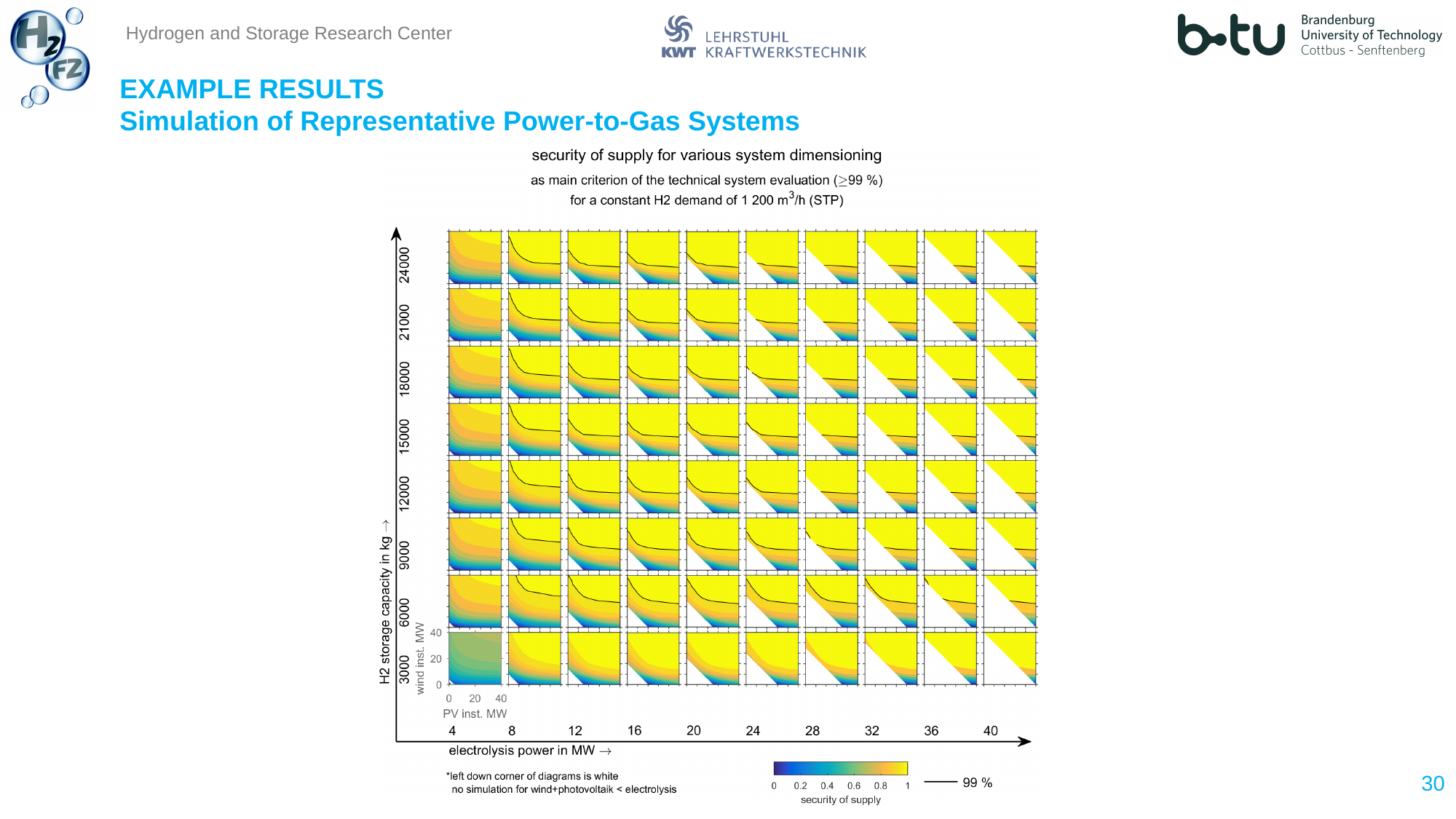
How many H2 storage capacity values are shown along the y axis of the grid? 8 What is the maximum wind installed capacity shown on the axis of each small diagram? 40 MW What is the largest electrolysis power value shown on the x axis? 40 MW What kind of chart is shown on the slide? A grid of contour (heat map) plots What is the smallest H2 storage capacity value shown on the y axis? 3000 kg What is the step between consecutive electrolysis power values on the x axis? 4 MW What is the largest H2 storage capacity value shown on the y axis? 24000 kg What does the black line in the diagrams represent? 99 % What is the smallest electrolysis power value shown on the x axis? 4 MW How many electrolysis power values are shown along the x axis of the grid? 10 What is the step between consecutive H2 storage capacity values on the y axis? 3000 kg What range does the security of supply colour bar cover? 0 to 1